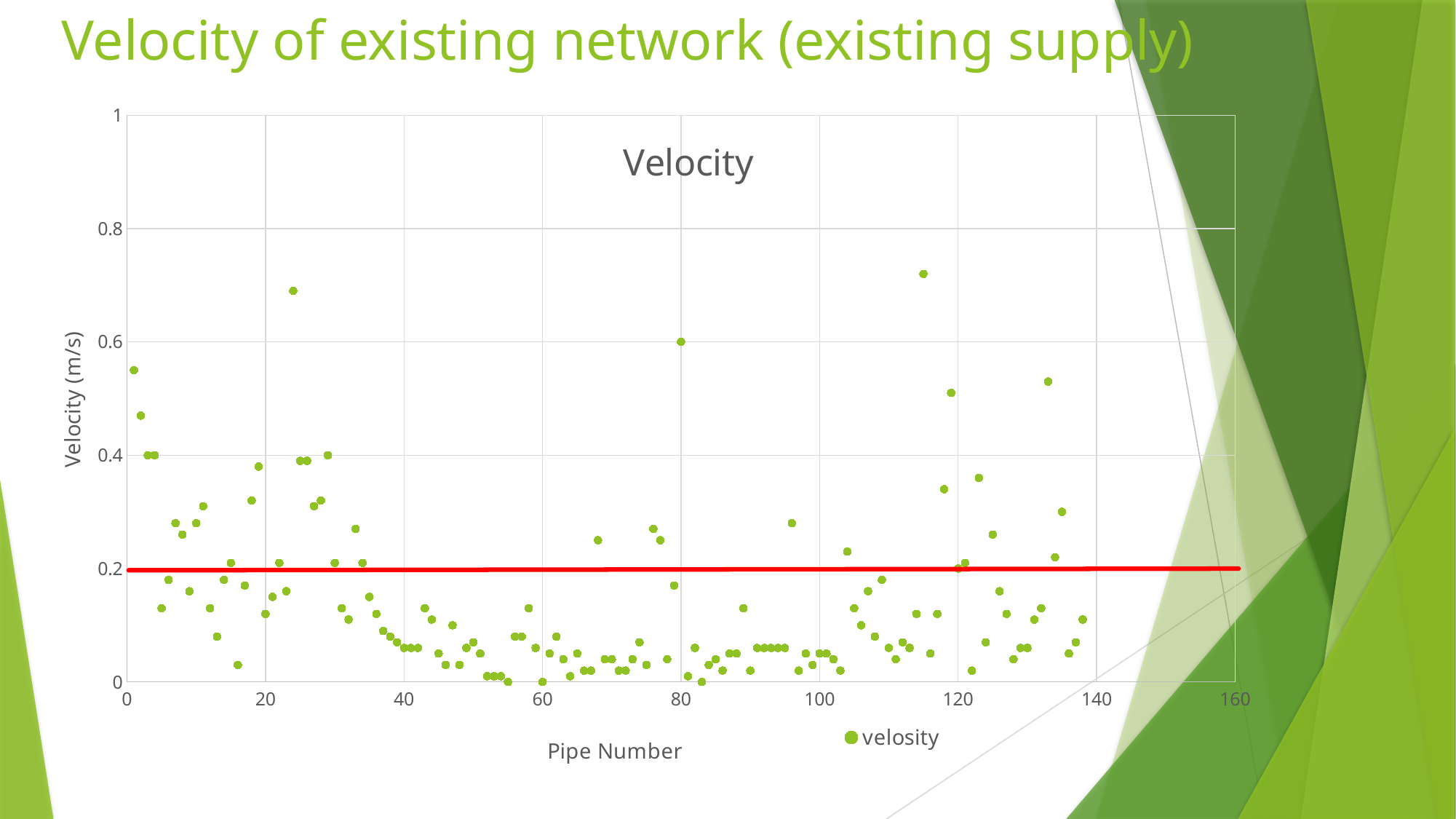
What series name does the chart legend list? velosity What kind of chart is shown on the slide? scatter chart What is the title of the chart? Velocity Which of the two points, at pipe number 80 or at pipe number 60, has the larger velocity value? pipe number 80 Is the velocity value plotted at pipe number 1 greater or less than 0.4? greater Is the velocity value plotted at pipe number 60 greater or less than 0.2? less Are any plotted velocity values greater than 0.8? No How many series does the legend list? 1